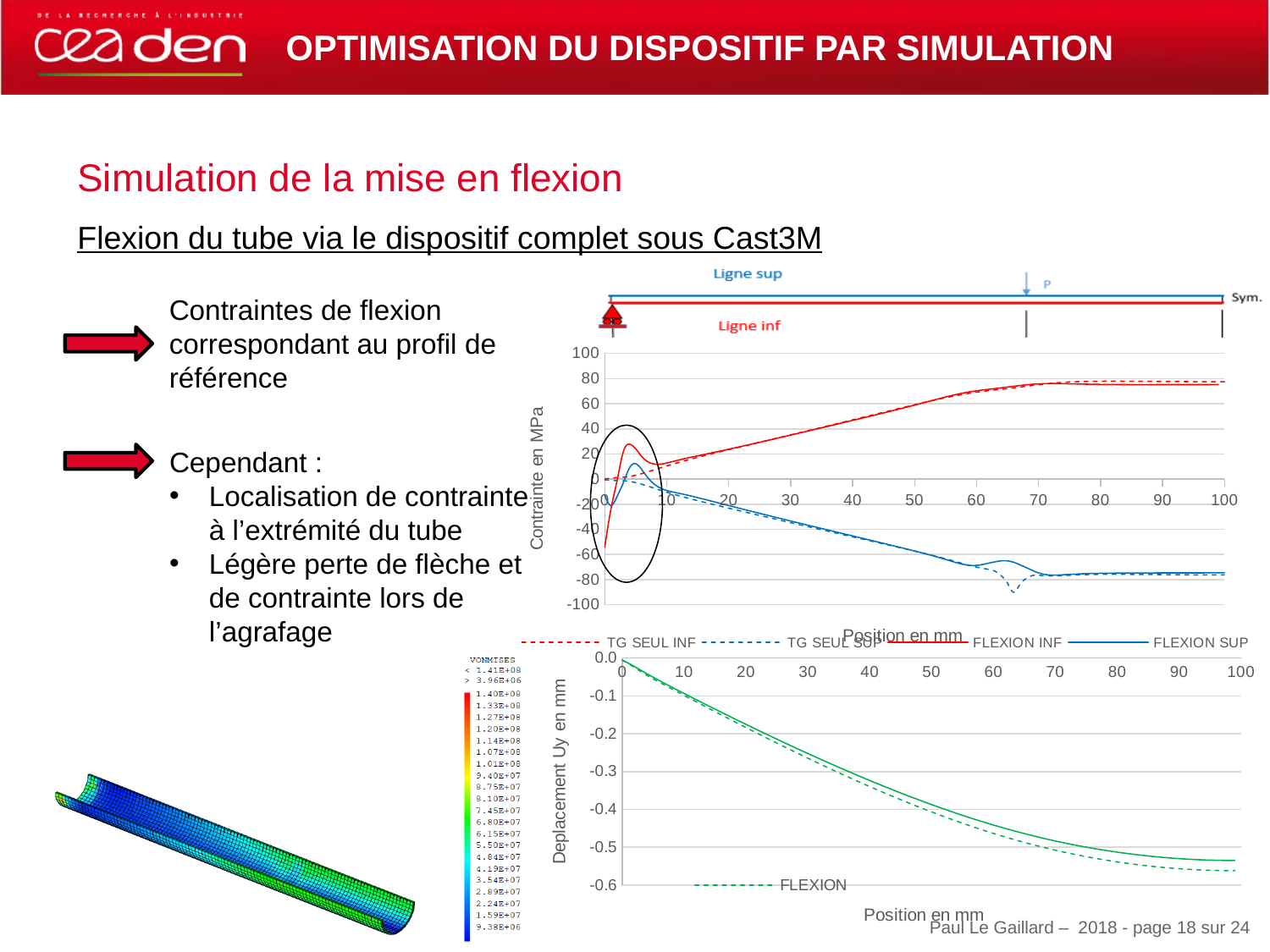
In the top chart (Contrainte en MPa), is the value of FLEXION SUP at position 100 greater or less than -60? less In the bottom chart (Deplacement Uy en mm), do the values rise or fall as position increases from 0 to 100? fall What is the y-axis title of the top chart? Contrainte en MPa What kind of chart is the bottom chart (Deplacement Uy en mm)? line chart In the bottom chart (Deplacement Uy en mm), is the value of the solid FLEXION line at position 100 greater or less than -0.5? less In the top chart (Contrainte en MPa), is the value of FLEXION INF at position 50 greater or less than 20? greater In the top chart (Contrainte en MPa), does the FLEXION INF series rise or fall between position 10 and position 70? rise What kind of chart is the top chart (Contrainte en MPa)? line chart How many series does the legend of the top chart (Contrainte en MPa) list? 4 In the top chart (Contrainte en MPa), does the FLEXION SUP series rise or fall between position 10 and position 60? fall